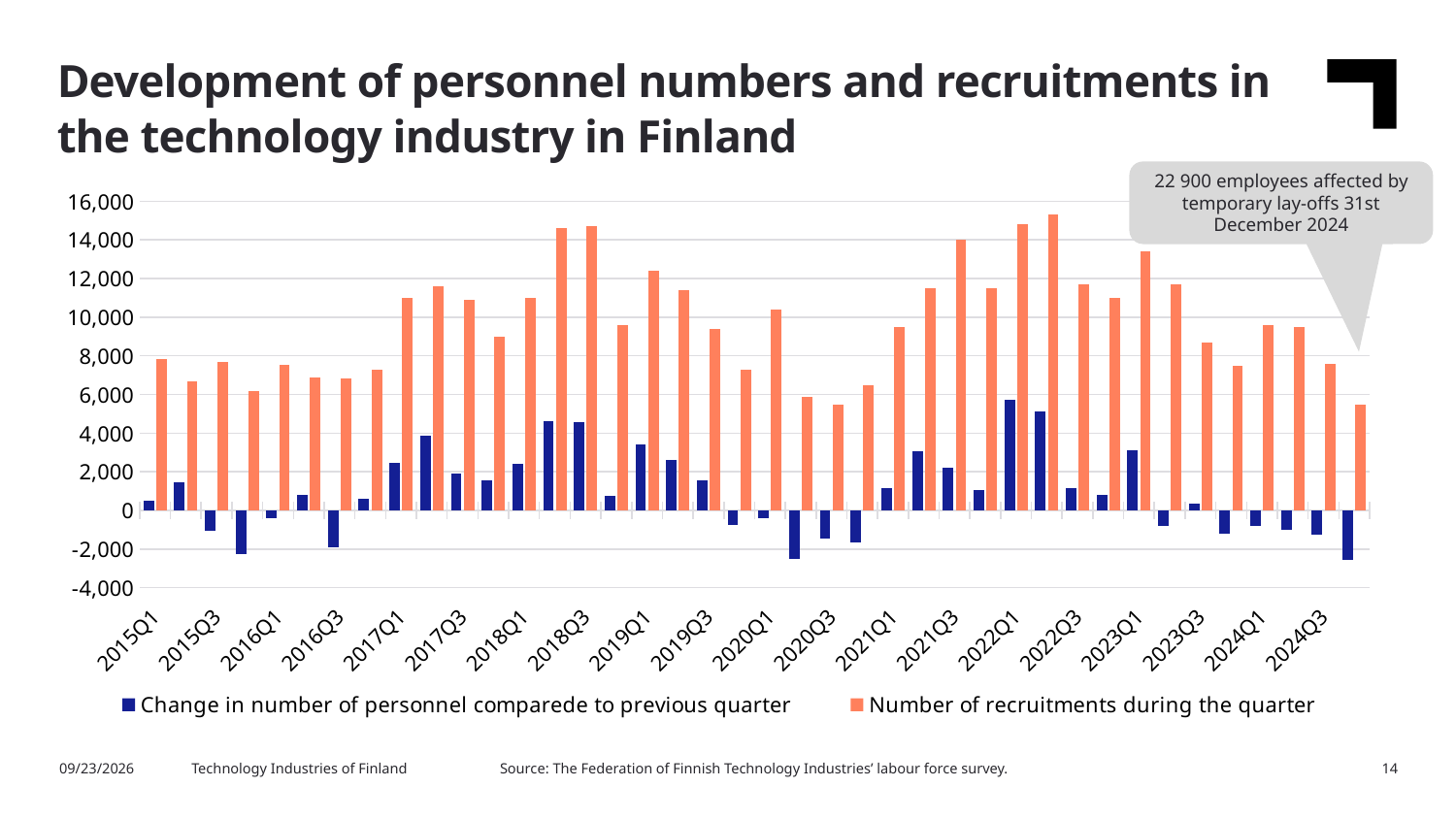
What kind of chart is shown on the slide? Bar chart Which quarter has more recruitments, 2018Q3 or 2019Q1? 2018Q3 Is the number of recruitments in 2017Q1 greater or less than 10,000? greater How many series does the legend list? 2 Is the number of recruitments in 2020Q3 greater or less than 6,000? less Is the number of recruitments in 2022Q2 greater or less than 14,000? greater Which quarter has the highest number of recruitments during the quarter? 2022Q2 Which quarter has a larger change in number of personnel, 2017Q2 or 2017Q3? 2017Q2 According to the callout on the chart, how many employees were affected by temporary lay-offs on 31st December 2024? 22 900 Which quarter has the highest change in number of personnel compared to previous quarter? 2022Q1